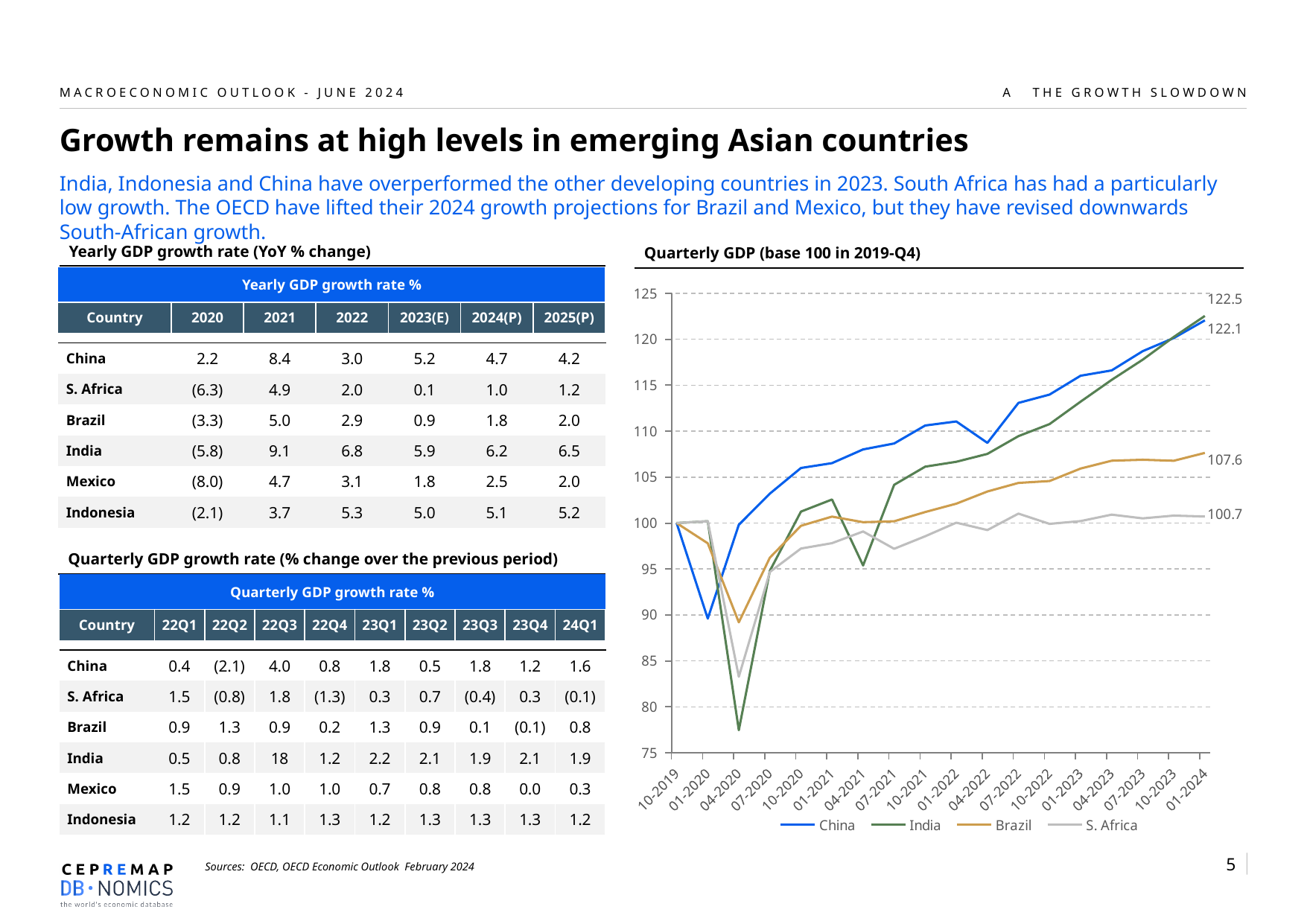
In the Quarterly GDP chart, what is the highest end-of-line value labelled at 01-2024? 122.5 In the Quarterly GDP chart, what is the value labelled at the end of the Brazil line in 01-2024? 107.6 In the Quarterly GDP chart, at 01-2024, which is larger: the Brazil value or the S. Africa value? Brazil In the Quarterly GDP chart, what is the value labelled at the end of the S. Africa line in 01-2024? 100.7 In the Quarterly GDP chart, is the value for India in 04-2020 greater or less than 80? less In the Quarterly GDP chart, what is the difference between the labelled 01-2024 values for Brazil and S. Africa? 6.9 What kind of chart is the "Quarterly GDP (base 100 in 2019-Q4)" chart? Line chart In the Quarterly GDP chart, which series falls to the lowest point in 04-2020? India In the Quarterly GDP chart, is the value for S. Africa in 04-2020 greater or less than 85? less How many series does the legend of the Quarterly GDP chart list? 4 How many quarterly dates are labelled on the x axis of the Quarterly GDP chart? 18 In the Quarterly GDP chart, is the value for China in 01-2022 greater or less than 105? greater